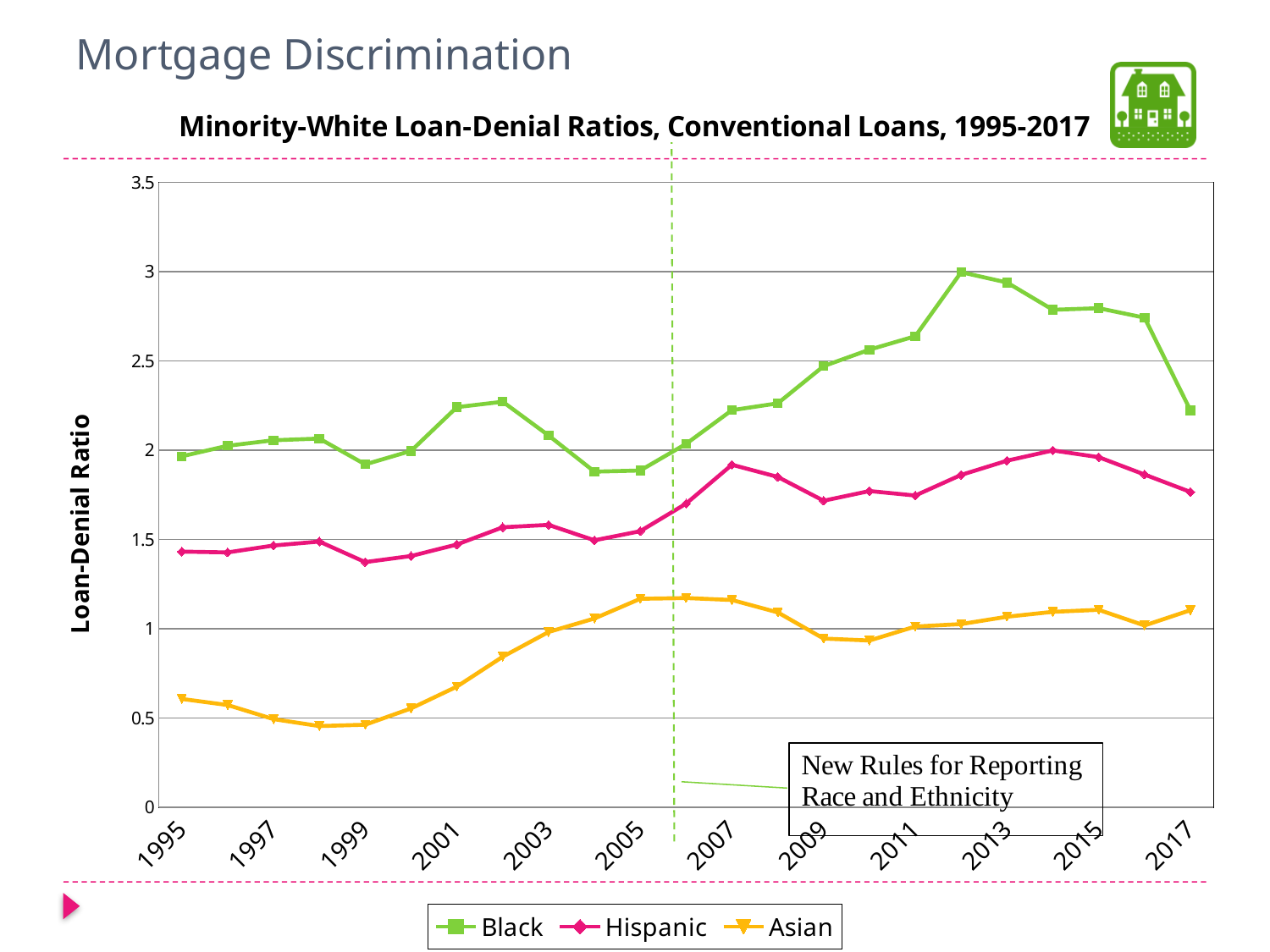
Is the Black loan-denial ratio in 2012 greater or less than 2.5? greater Does the Black loan-denial ratio rise or fall from 2012 to 2017? fall Which series has the highest loan-denial ratio in 2017? Black Is the Hispanic loan-denial ratio in 2007 greater or less than 1.5? greater What is the label on the y axis? Loan-Denial Ratio In 2005, which is larger: the Black or the Hispanic loan-denial ratio? Black Which series has the lowest loan-denial ratio across the whole period? Asian How many series does the legend list? 3 What does the annotation next to the vertical dashed line say? New Rules for Reporting Race and Ethnicity Is the Black loan-denial ratio in 2017 greater or less than 2? greater What kind of chart is shown on the slide? line chart